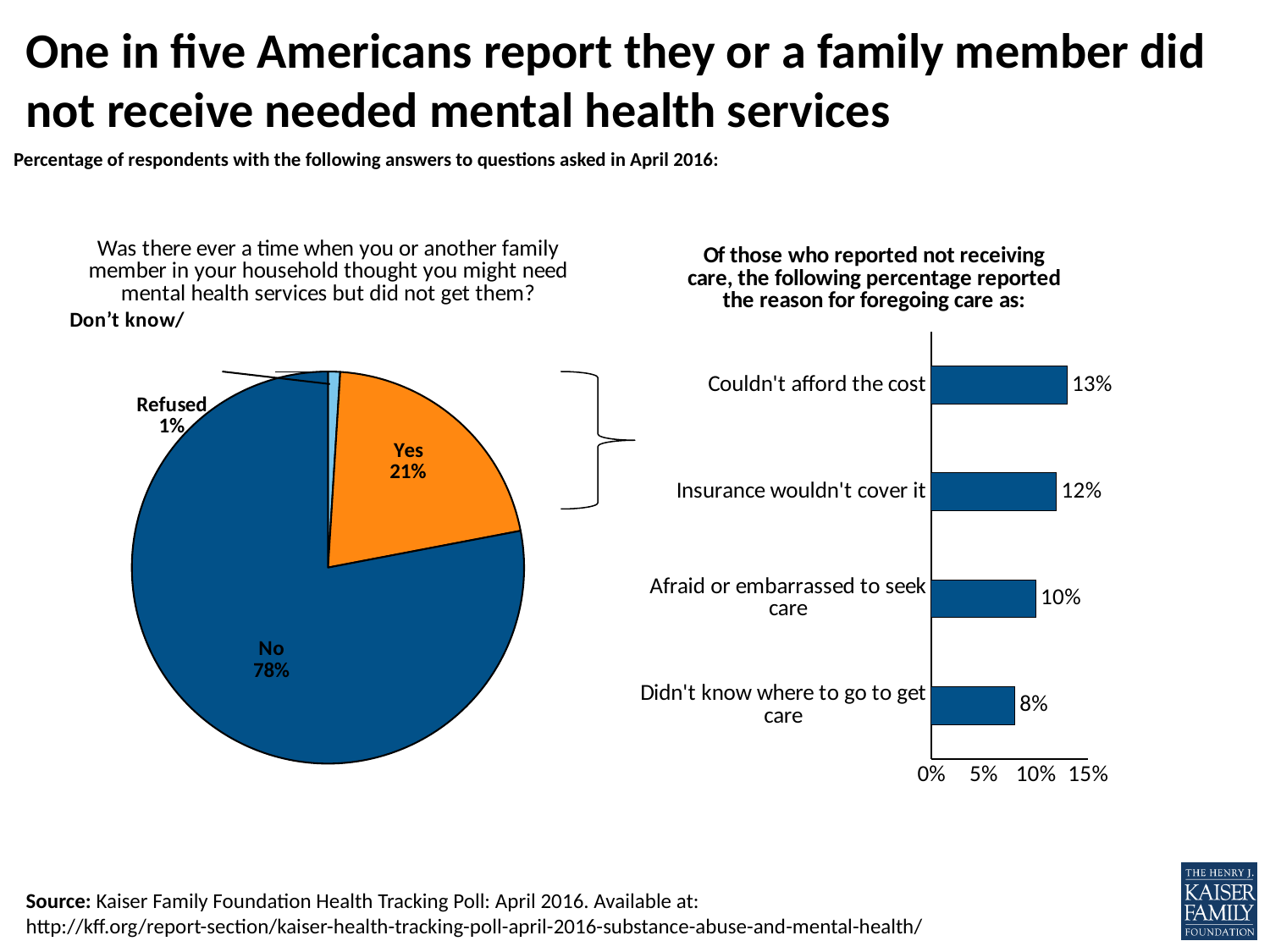
In the bar chart on the right, how many reasons are listed? 4 In the bar chart on the right, what percentage reported "Couldn't afford the cost" as the reason for foregoing care? 13% In the pie chart on the left, what percentage of respondents answered "Yes"? 21% In the bar chart on the right, which reason has the lowest percentage? Didn't know where to go to get care In the bar chart on the right, what is the difference between "Insurance wouldn't cover it" and "Afraid or embarrassed to seek care"? 2% In the bar chart on the right, what percentage reported "Didn't know where to go to get care"? 8% In the pie chart on the left, how many slices are there? 3 In the pie chart on the left, which answer has the largest slice? No In the pie chart on the left, what percentage answered "Don't know/Refused"? 1% What type of chart is shown on the right side of the slide? Bar chart In the bar chart on the right, which reason has the highest percentage? Couldn't afford the cost In the pie chart on the left, what percentage of respondents answered "No"? 78%